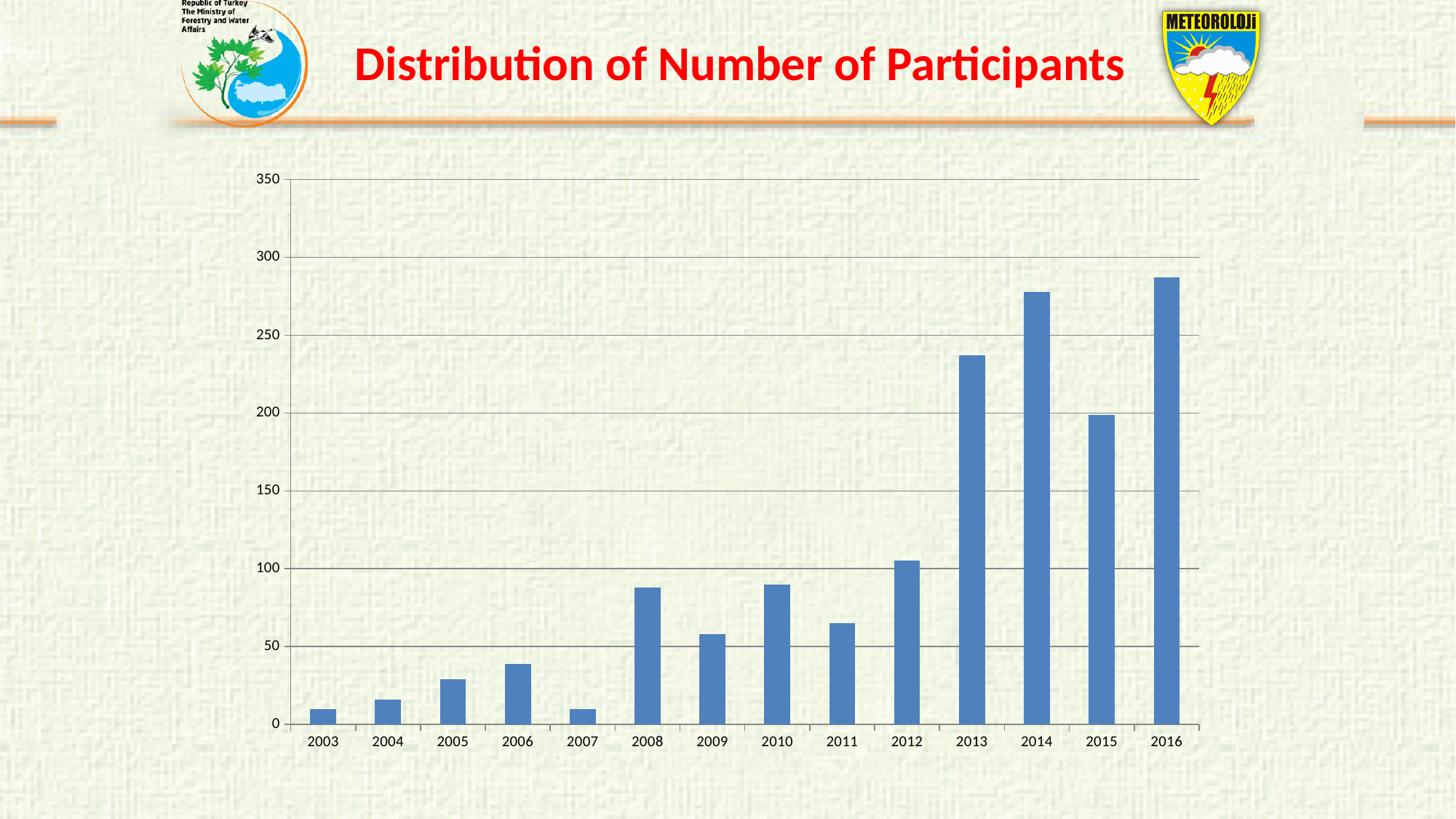
What is the title of the chart? Distribution of Number of Participants Overall, do the number of participants rise or fall from 2003 to 2016? Rise Is the value for 2013 greater or less than 200? greater Which year has more participants, 2011 or 2012? 2012 Is the value for 2008 greater or less than 50? greater Which year has the highest number of participants? 2016 What kind of chart is shown on the slide? Bar chart Is the value for 2014 greater or less than 250? greater How many years are shown on the x axis of the chart? 14 Which year has more participants, 2013 or 2015? 2013